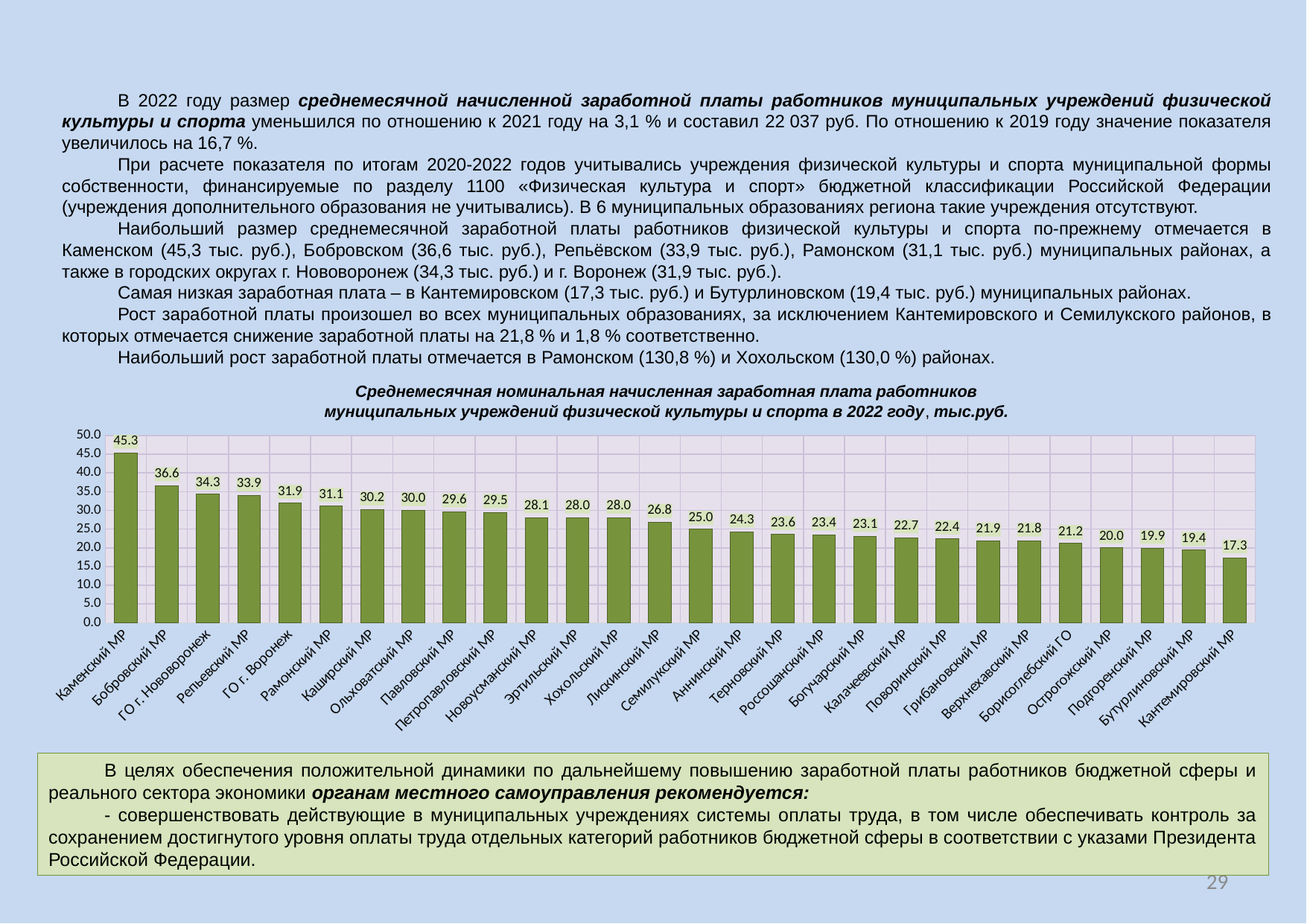
What type of chart is shown on the slide? Bar chart How many categories are shown on the x axis? 28 What is the value for Каменский МР? 45.3 What is the difference between the values for Каменский МР and Бобровский МР? 8.7 What unit is stated in the chart title? тыс.руб. What is the value for Борисоглебский ГО? 21.2 Which is larger, the value for Рамонский МР or the value for Семилукский МР? Рамонский МР Which category has the lowest value? Кантемировский МР Do the values rise or fall from left to right along the x axis? Fall What is the value for ГО г. Воронеж? 31.9 What is the value for Лискинский МР? 26.8 Which category has the highest value? Каменский МР